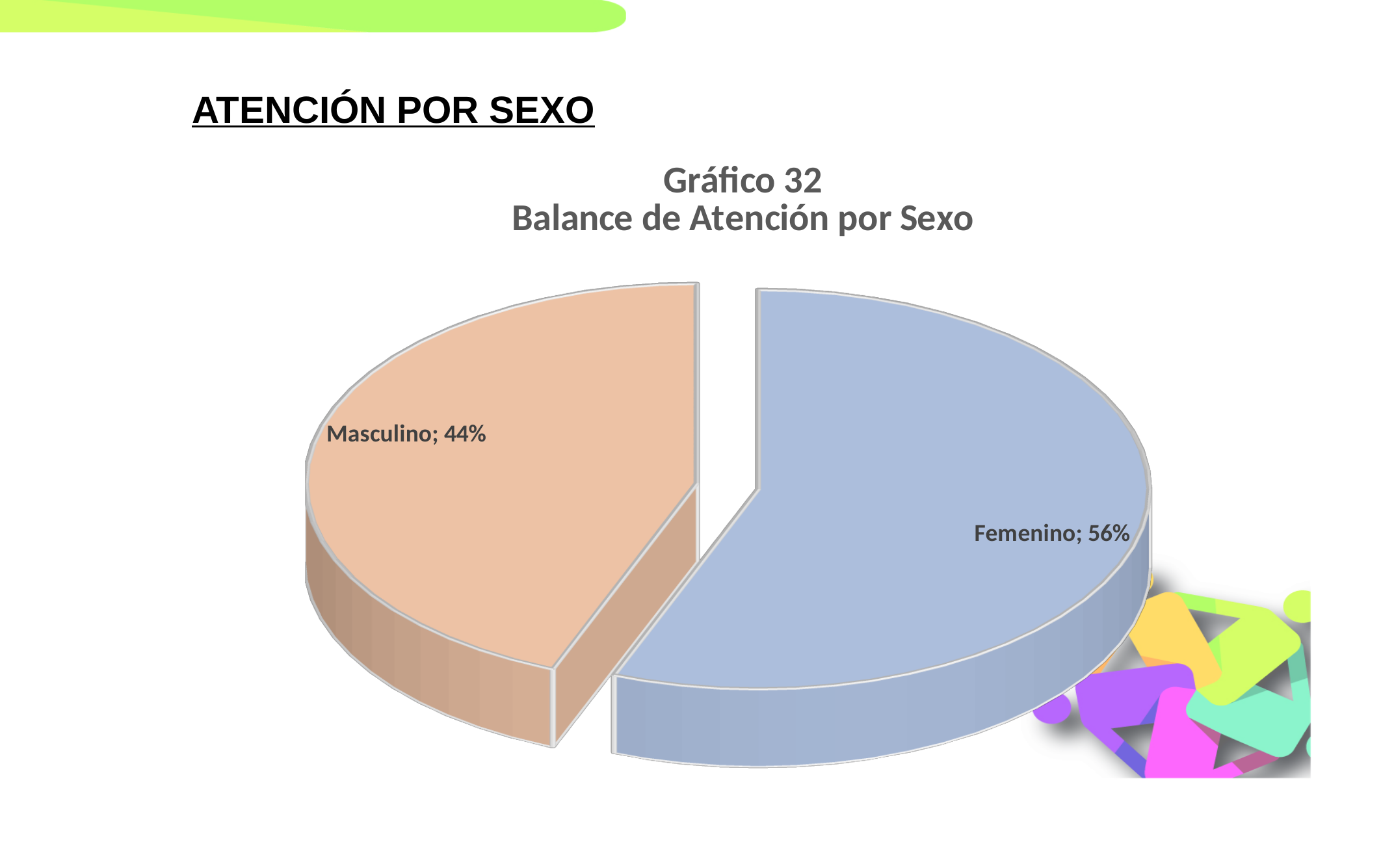
Which is larger, the Femenino slice or the Masculino slice? Femenino What percentage does the Femenino slice represent? 56% What share of the pie does the Masculino slice take? 44% What colour is the Femenino slice? Blue Which category has the largest share of the pie? Femenino What kind of chart is shown on the slide? Pie chart How many slices does the pie chart have? 2 Which category has the smallest share of the pie? Masculino What percentage does the Masculino slice represent? 44% What is the difference in percentage points between the Femenino and Masculino slices? 12 What is the title of the chart? Gráfico 32 Balance de Atención por Sexo